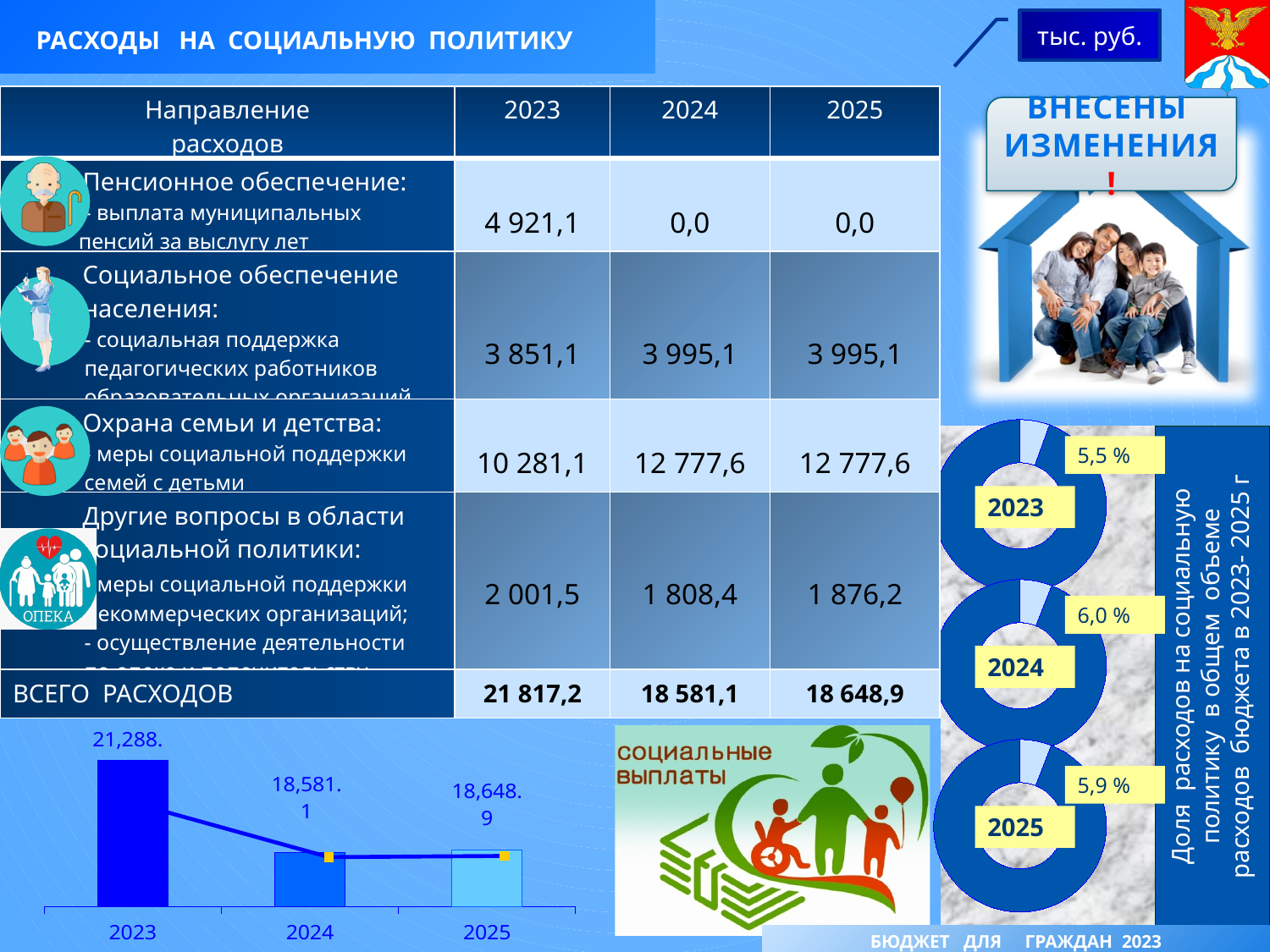
In the donut charts on the right of the slide, what share of total budget expenditure does social policy have in 2023? 5,5 % In the bar chart at the bottom left of the slide, which year has the lowest value? 2024 In the donut charts on the right of the slide, what share is shown for 2024? 6,0 % In the bar chart at the bottom left of the slide, what is the difference between the values for 2025 and 2024? 67.8 In the bar chart at the bottom left of the slide, what is the value shown for 2025? 18,648.9 What kind of chart is shown at the bottom left of the slide? Bar chart In the bar chart at the bottom left of the slide, does the value rise or fall from 2023 to 2024? Fall In the bar chart at the bottom left of the slide, what is the value shown for 2024? 18,581.1 How many years (categories) are shown in the bar chart at the bottom left of the slide? 3 In the bar chart at the bottom left of the slide, which year has the highest bar? 2023 In the donut charts on the right of the slide, which year has the highest share of social policy expenditure? 2024 In the bar chart at the bottom left of the slide, which is larger: the value for 2023 or the value for 2025? 2023